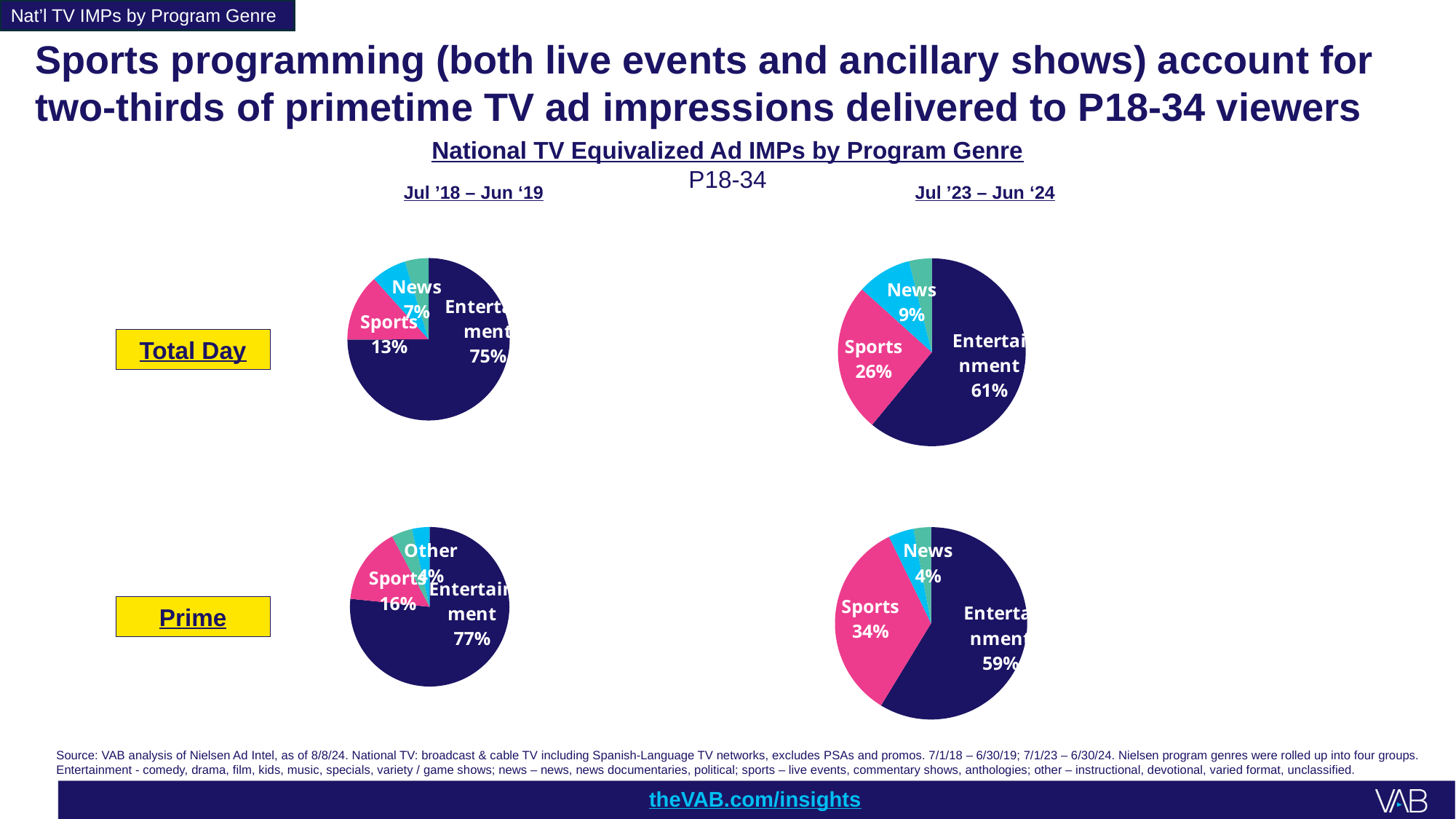
In the Prime pie chart for Jul '18 – Jun '19, what is the Sports share? 16% In the Total Day pie chart for Jul '18 – Jun '19, what share of ad impressions does Entertainment account for? 75% In the Total Day pie chart for Jul '18 – Jun '19, which is larger, the Sports slice or the News slice? Sports What is the difference between the Entertainment share in the Total Day Jul '18 – Jun '19 pie and the Total Day Jul '23 – Jun '24 pie? 14 percentage points In the Prime pie chart for Jul '23 – Jun '24, which genre has the largest slice? Entertainment How much larger is the Sports share in the Prime Jul '23 – Jun '24 pie than in the Prime Jul '18 – Jun '19 pie? 18 percentage points How many pie charts are shown on the slide? 4 In the Total Day pie chart for Jul '23 – Jun '24, what is the News share? 9% In the Total Day pie chart for Jul '23 – Jun '24, what is the Sports share? 26% In the Prime pie chart for Jul '23 – Jun '24, what share does Entertainment have? 59% What type of chart is used on this slide? Pie chart What is the title of the chart group on the slide? National TV Equivalized Ad IMPs by Program Genre